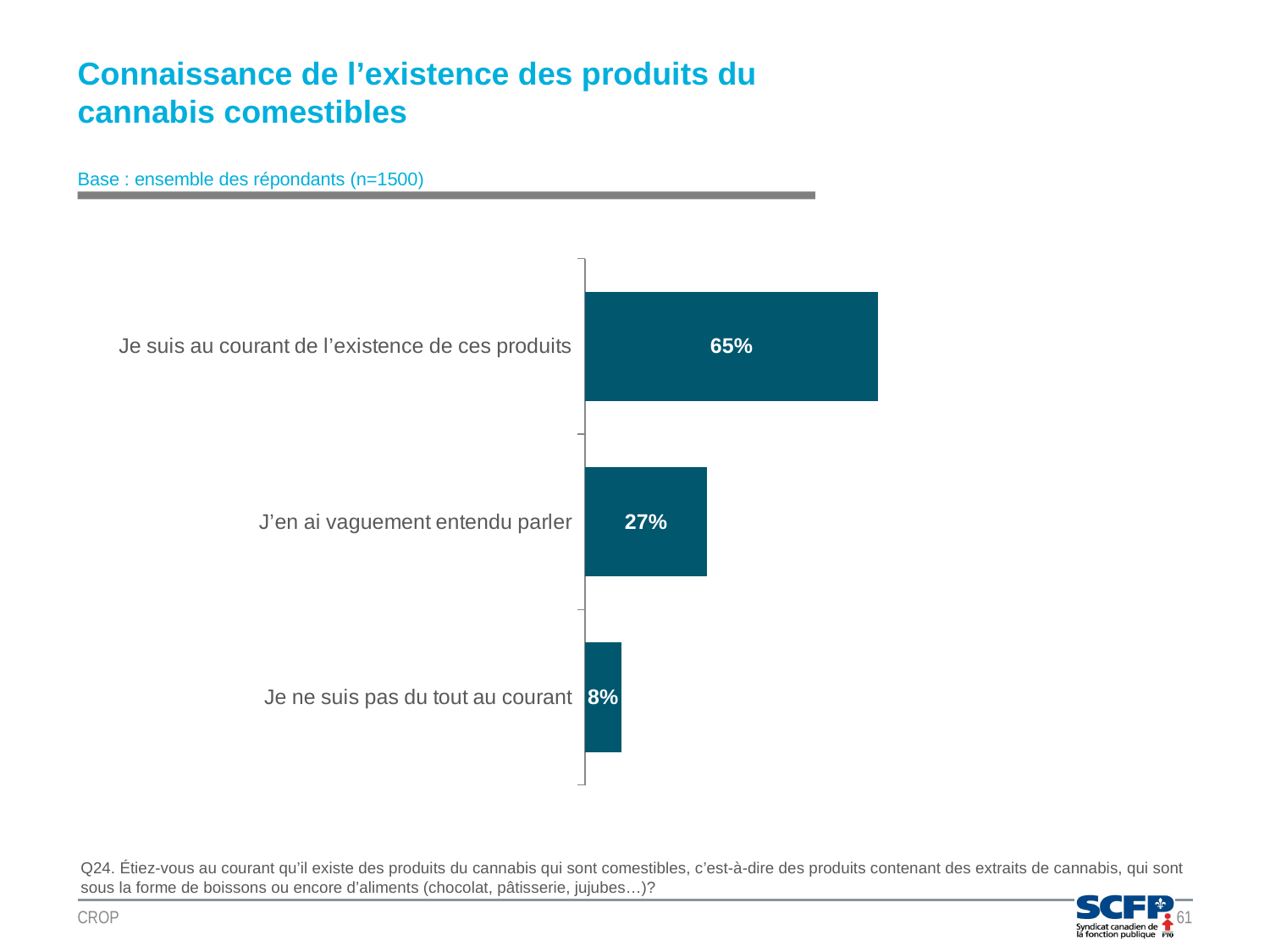
What is the total of the three values shown in the chart? 100% What is the value for "Je suis au courant de l’existence de ces produits"? 65% What is the value for "J’en ai vaguement entendu parler"? 27% How many categories are shown in the chart? 3 What is the title of the slide containing the chart? Connaissance de l’existence des produits du cannabis comestibles Which is larger: the value for "J’en ai vaguement entendu parler" or the value for "Je ne suis pas du tout au courant"? J’en ai vaguement entendu parler What is the difference between the values for "Je suis au courant de l’existence de ces produits" and "J’en ai vaguement entendu parler"? 38% What is the difference between the values for "J’en ai vaguement entendu parler" and "Je ne suis pas du tout au courant"? 19% What kind of chart is shown on the slide? Bar chart Which category has the lowest value? Je ne suis pas du tout au courant What is the value for "Je ne suis pas du tout au courant"? 8% Which category has the highest value? Je suis au courant de l’existence de ces produits